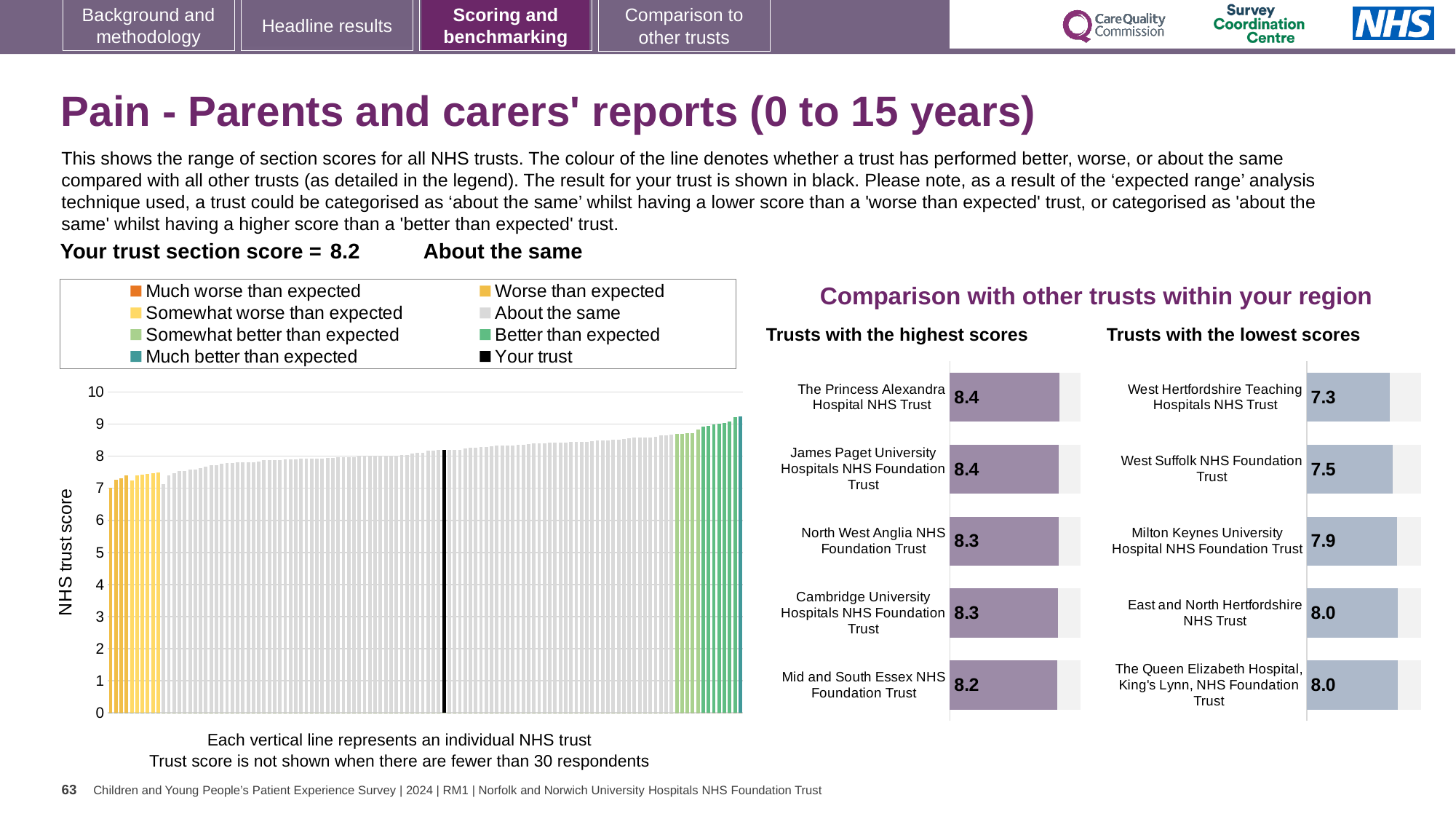
On the 'Trusts with the lowest scores' chart, what is the score for West Hertfordshire Teaching Hospitals NHS Trust? 7.3 On the 'Trusts with the highest scores' chart, what is the score for Mid and South Essex NHS Foundation Trust? 8.2 On the 'Trusts with the lowest scores' chart, what is the score for Milton Keynes University Hospital NHS Foundation Trust? 7.9 On the large chart on the left, is the value of the lowest bar greater or less than 6? greater On the large chart on the left, do the trust scores rise or fall from left to right along the x axis? Rise How many entries does the legend above the large chart on the left list? 8 How many trusts are shown on the 'Trusts with the lowest scores' chart? 5 What type of chart is the large chart on the left showing NHS trust scores? Bar chart On the 'Trusts with the lowest scores' chart, what is the difference between the scores of West Suffolk NHS Foundation Trust and West Hertfordshire Teaching Hospitals NHS Trust? 0.2 On the 'Trusts with the highest scores' chart, which has the higher score: North West Anglia NHS Foundation Trust or Mid and South Essex NHS Foundation Trust? North West Anglia NHS Foundation Trust On the 'Trusts with the highest scores' chart, what is the score for The Princess Alexandra Hospital NHS Trust? 8.4 On the 'Trusts with the lowest scores' chart, which trust has the lowest score? West Hertfordshire Teaching Hospitals NHS Trust